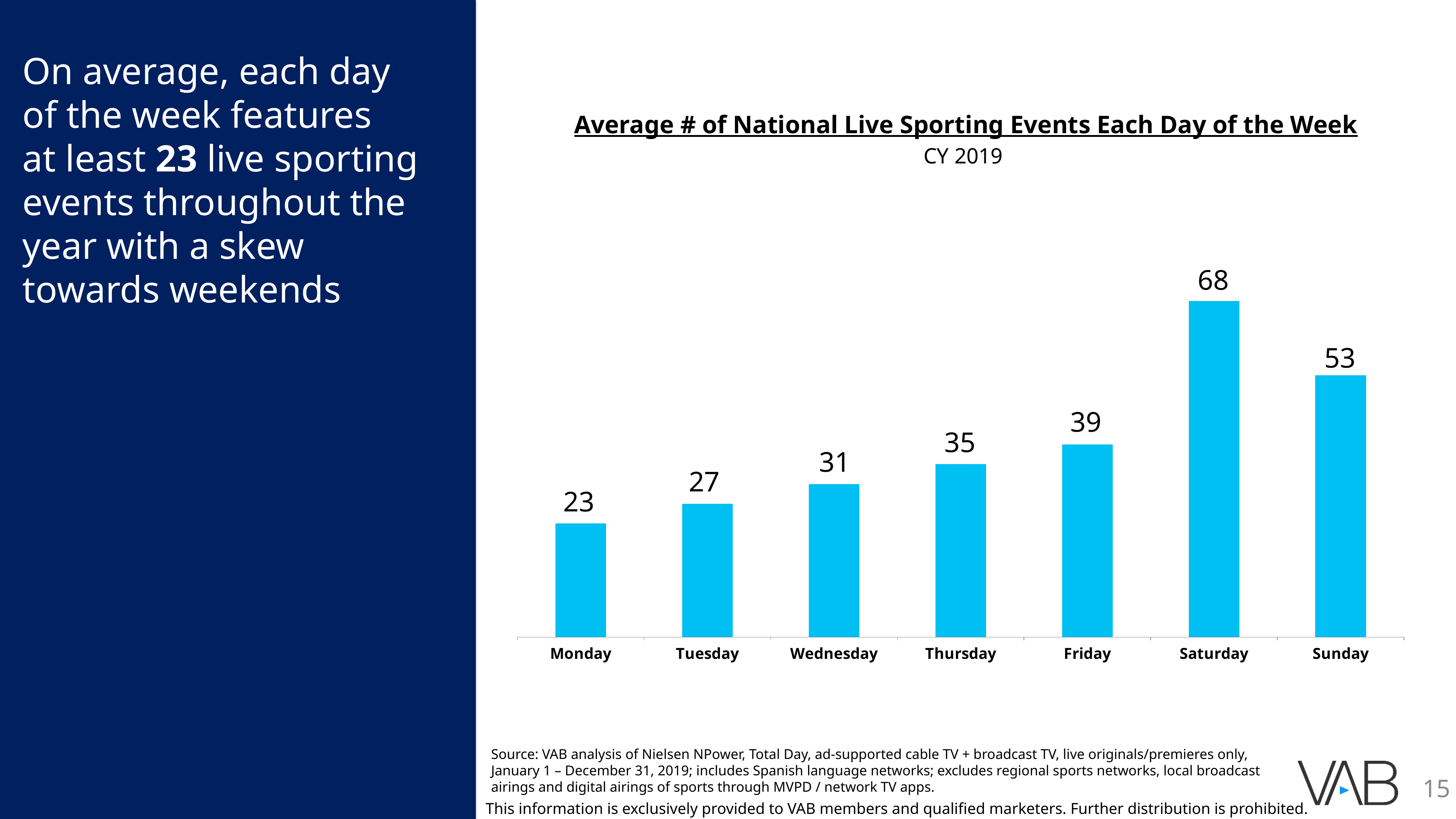
Which day of the week has the lowest average number of national live sporting events? Monday What is the title of the chart? Average # of National Live Sporting Events Each Day of the Week What calendar year does the chart cover? CY 2019 What is the average number of national live sporting events on Wednesday? 31 How many days of the week are shown on the chart? 7 What is the difference between the average number of live sporting events on Saturday and on Sunday? 15 What kind of chart is shown on the slide? Bar chart What is the difference between the average number of live sporting events on Friday and on Monday? 16 What is the average number of national live sporting events on Saturday? 68 Which day has more average live sporting events, Thursday or Tuesday? Thursday Do the values rise or fall from Monday through Saturday? Rise Which day of the week has the highest average number of national live sporting events? Saturday